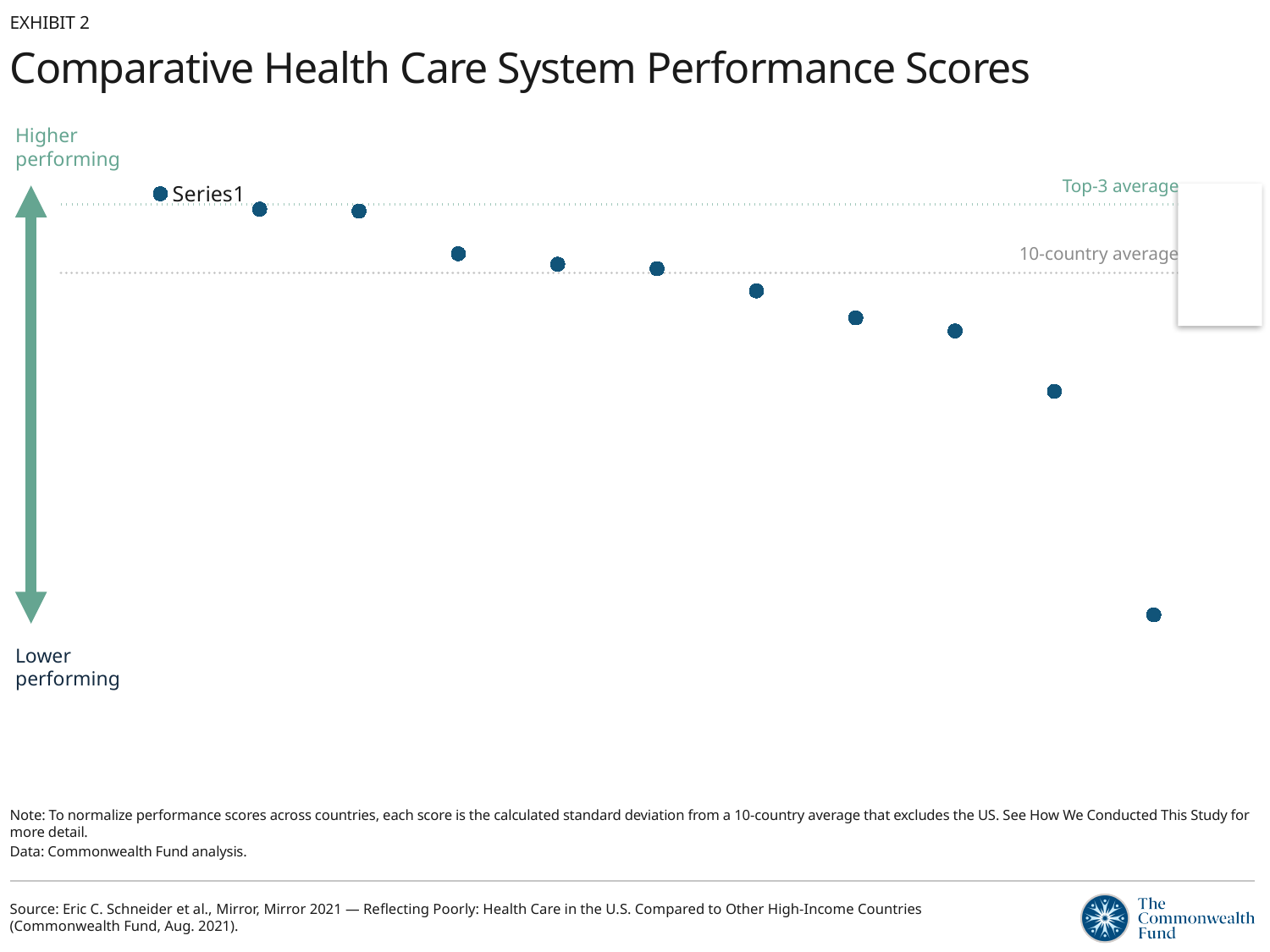
What kind of chart is shown on the slide? Scatter chart What is the title of the chart? Comparative Health Care System Performance Scores Do the plotted values rise or fall moving from left to right along the x axis? Fall How many data points are plotted in the chart? 11 What are the two dotted reference lines in the chart labelled? Top-3 average and 10-country average